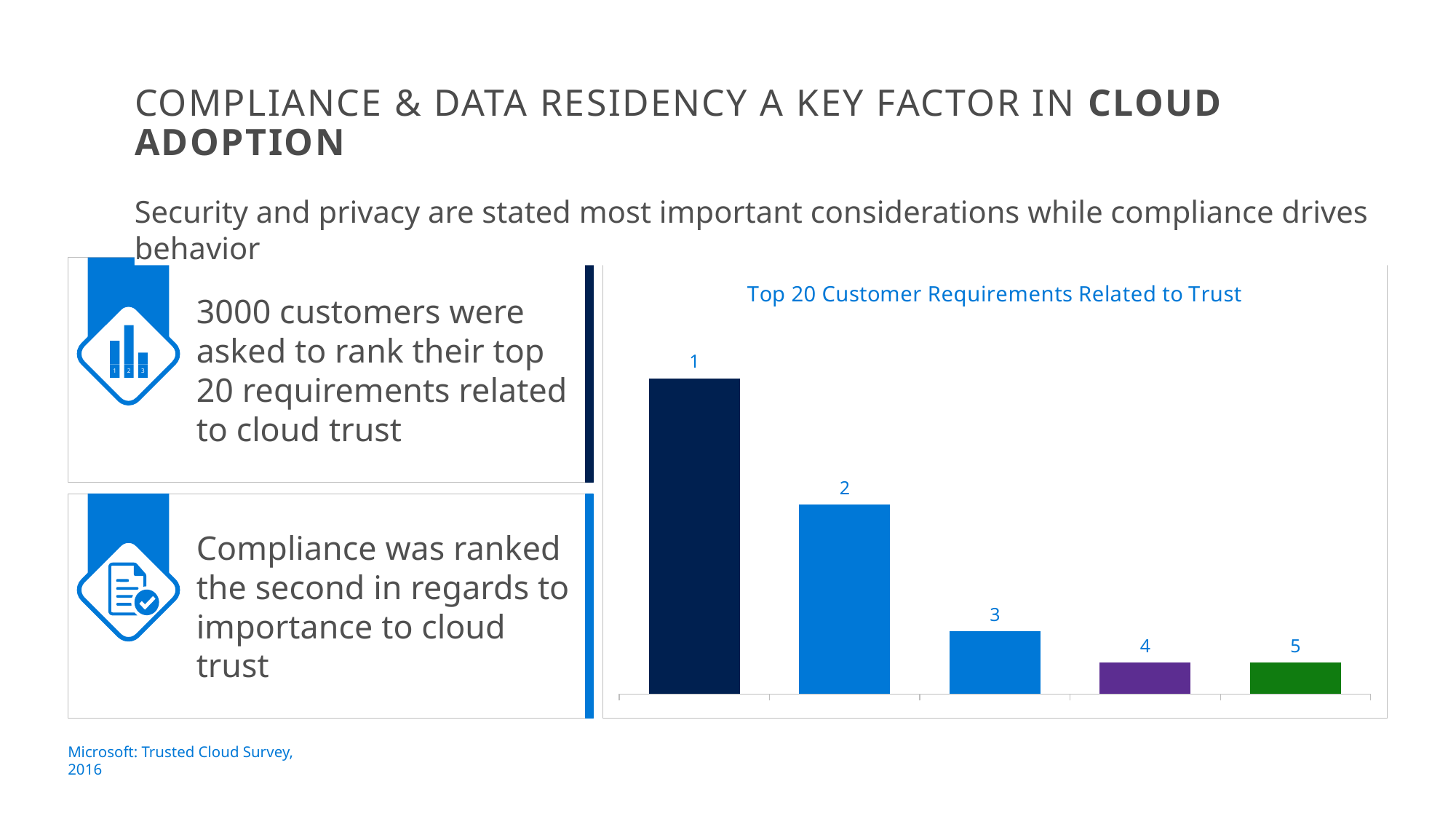
Do the bar heights rise or fall from left to right across the chart? fall Which data label is printed above the tallest bar in the chart? 1 What is the title of the chart? Top 20 Customer Requirements Related to Trust What data label is printed above the leftmost bar? 1 Is the bar labelled 1 taller or shorter than the bar labelled 2? taller How many bars does the chart show? 5 What kind of chart is shown on the slide? bar chart What data label is printed above the rightmost bar? 5 Is the bar labelled 2 taller or shorter than the bar labelled 3? taller What colour is the bar labelled 5? green